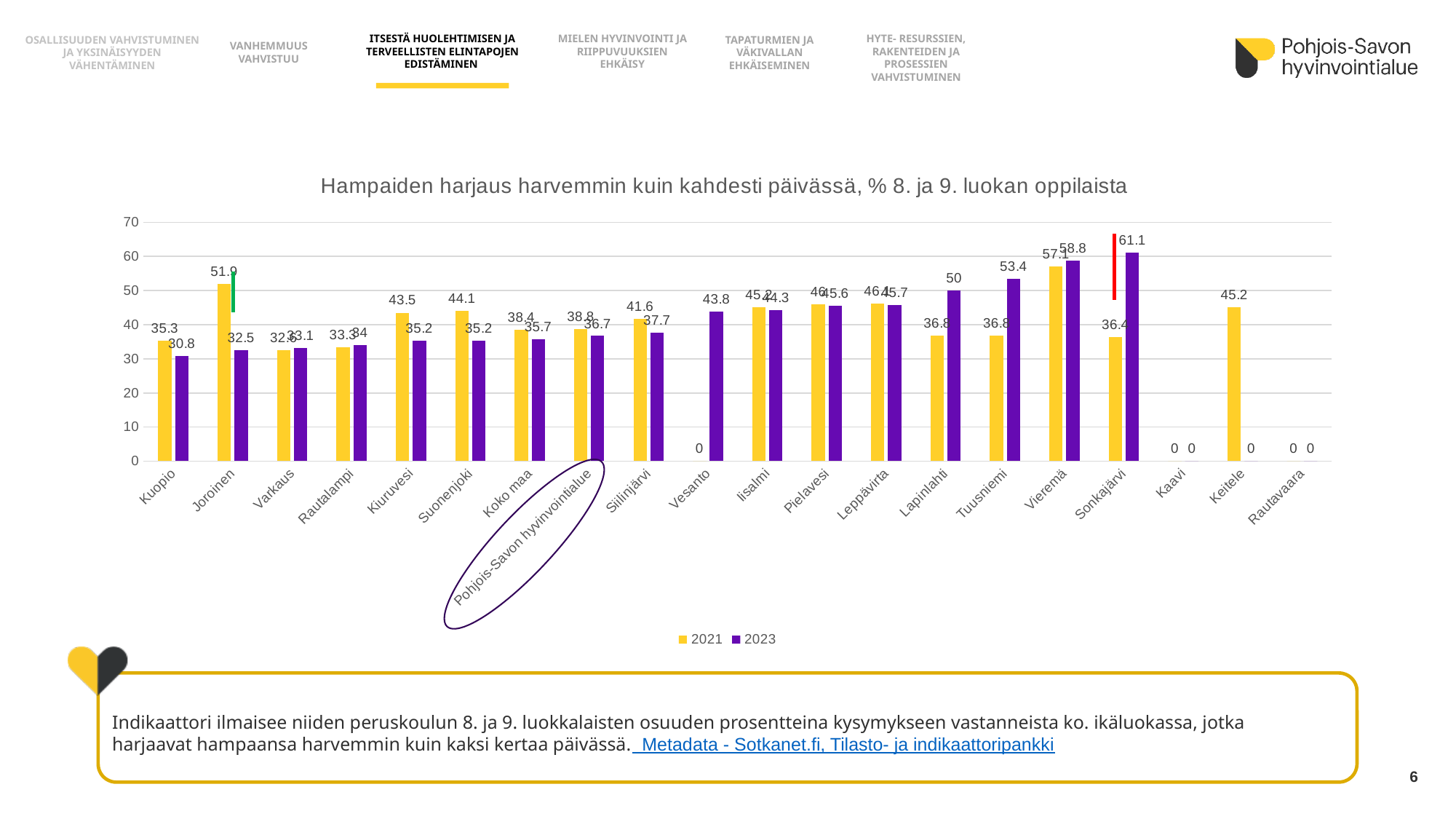
What are the two entries in the legend? 2021 and 2023 What is the 2021 value for Keitele? 45.2 How many categories are shown on the x axis? 20 What is the 2023 value for Sonkajärvi? 61.1 How many series does the legend list? 2 Which category has the highest 2021 value? Vieremä For Lapinlahti, which year has the larger value, 2021 or 2023? 2023 What kind of chart is shown on the slide? bar chart What is the 2021 value for Joroinen? 51.9 What is the 2023 value for Vesanto? 43.8 What is the difference between the 2021 and 2023 values for Joroinen? 19.4 Which category has the highest 2023 value? Sonkajärvi